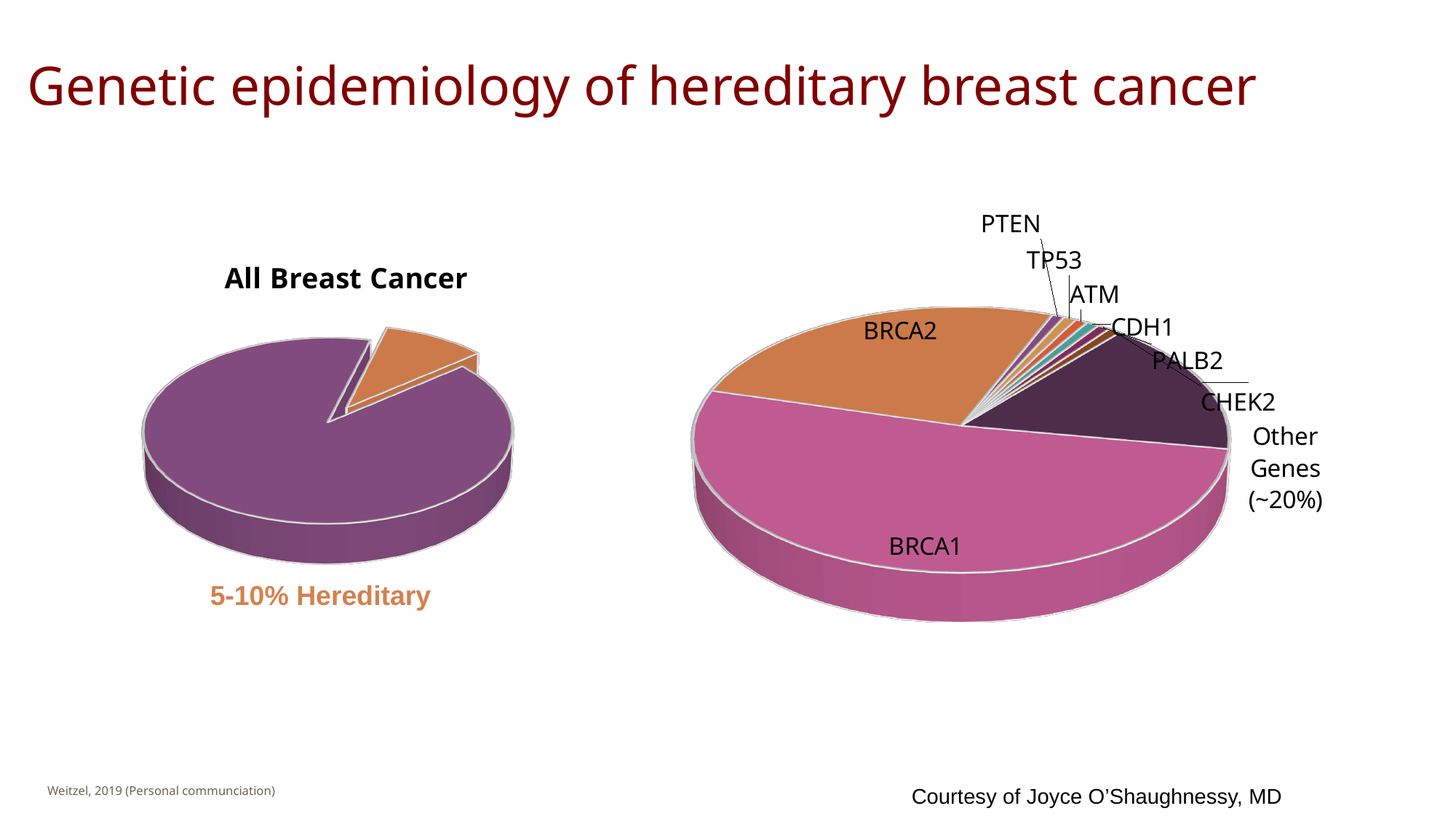
In the right chart, which slice is larger, BRCA1 or BRCA2? BRCA1 In the left chart, how many slices does the pie have? 2 In the right chart, which slice is larger, BRCA1 or Other Genes? BRCA1 In the left chart, what label is given to the small orange slice? 5-10% Hereditary What kind of chart is the right chart showing BRCA1, BRCA2 and other genes? Pie chart In the right chart, what colour is the BRCA2 slice? Orange In the right chart, which gene has the largest slice? BRCA1 What is the title of the left chart? All Breast Cancer What kind of chart is the left chart titled "All Breast Cancer"? Pie chart In the left chart, which slice is smaller, the purple slice or the orange hereditary slice? The orange hereditary slice In the right chart, how many labeled gene categories are shown? 9